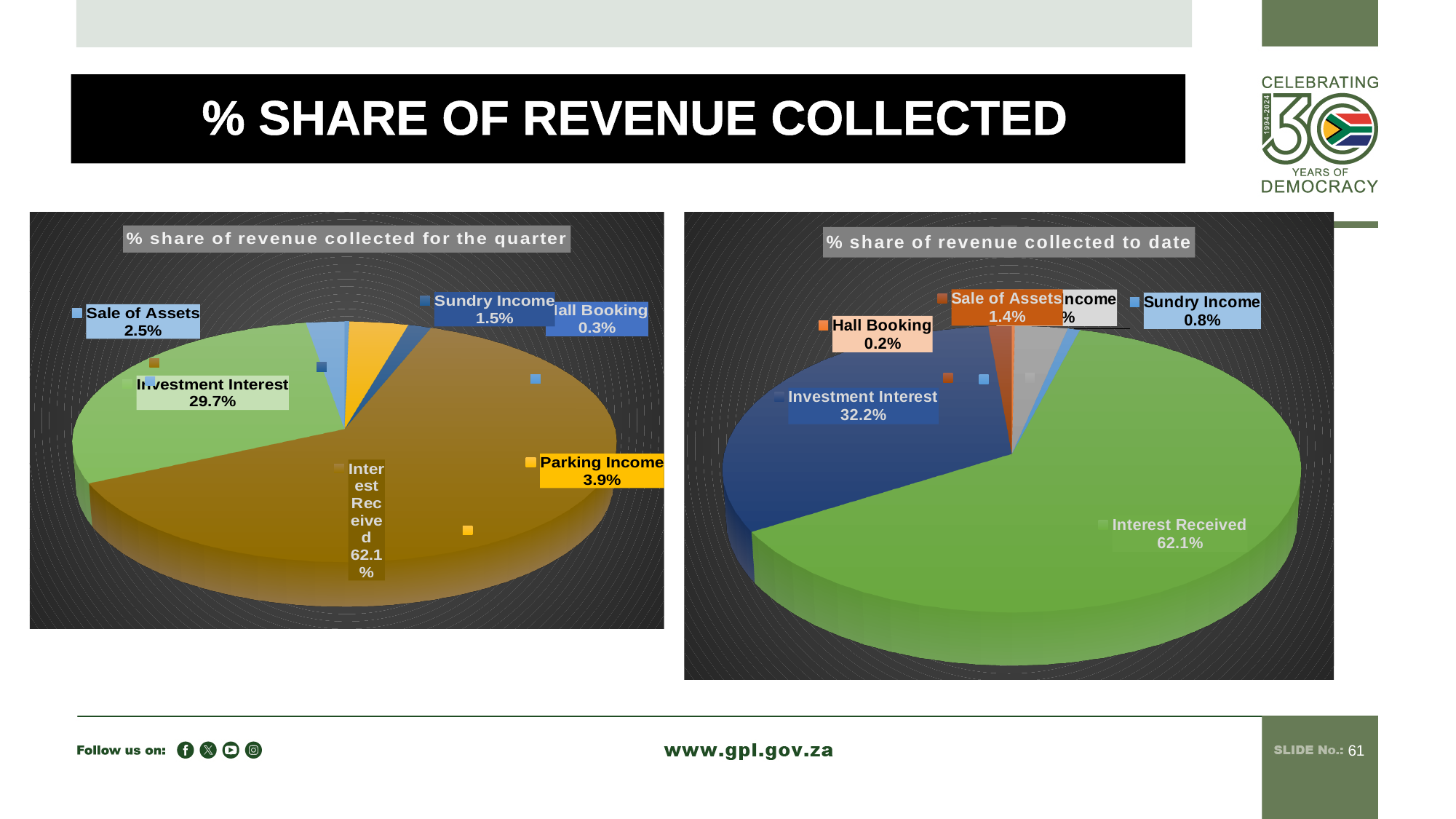
In the '% share of revenue collected for the quarter' chart, what is the share for Parking Income? 3.9% In the '% share of revenue collected to date' chart, which is larger: Sundry Income or Hall Booking? Sundry Income In the '% share of revenue collected for the quarter' chart, what is the difference between the shares of Sale of Assets and Sundry Income? 1.0% In the '% share of revenue collected to date' chart, which category has the largest share? Interest Received What type of chart is used in the '% share of revenue collected for the quarter' chart? pie chart In the '% share of revenue collected to date' chart, what is the share for Sale of Assets? 1.4% In the '% share of revenue collected for the quarter' chart, which category has the largest share? Interest Received In the '% share of revenue collected to date' chart, what is the share for Investment Interest? 32.2% How many categories are shown in the '% share of revenue collected for the quarter' chart? 6 In the '% share of revenue collected for the quarter' chart, what is the share for Investment Interest? 29.7% In the '% share of revenue collected for the quarter' chart, which category has the smallest share? Hall Booking What is the title of the chart on the right side of the slide? % share of revenue collected to date